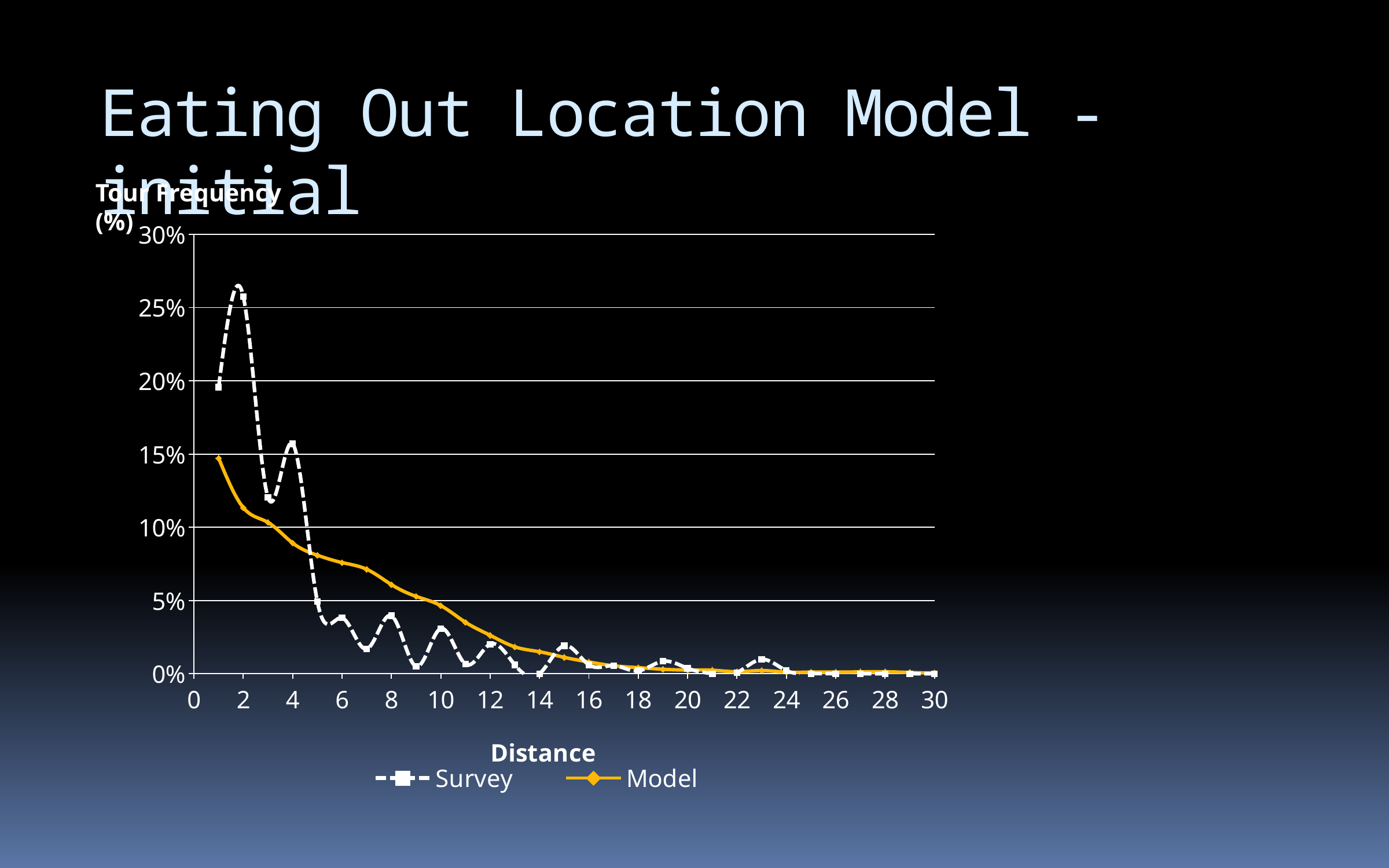
Does the Model series generally rise or fall as distance increases? fall What kind of chart is shown on the slide? line chart What is the title of the x axis? Distance What are the two series named in the legend? Survey and Model Is the Survey value at distance 3 greater or less than 15%? less At distance 2, which series has the higher value, Survey or Model? Survey Is the Model value at distance 12 greater or less than 5%? less Is the Survey value at distance 14 greater or less than 5%? less How many series does the legend list? 2 At distance 8, which series has the higher value, Survey or Model? Model